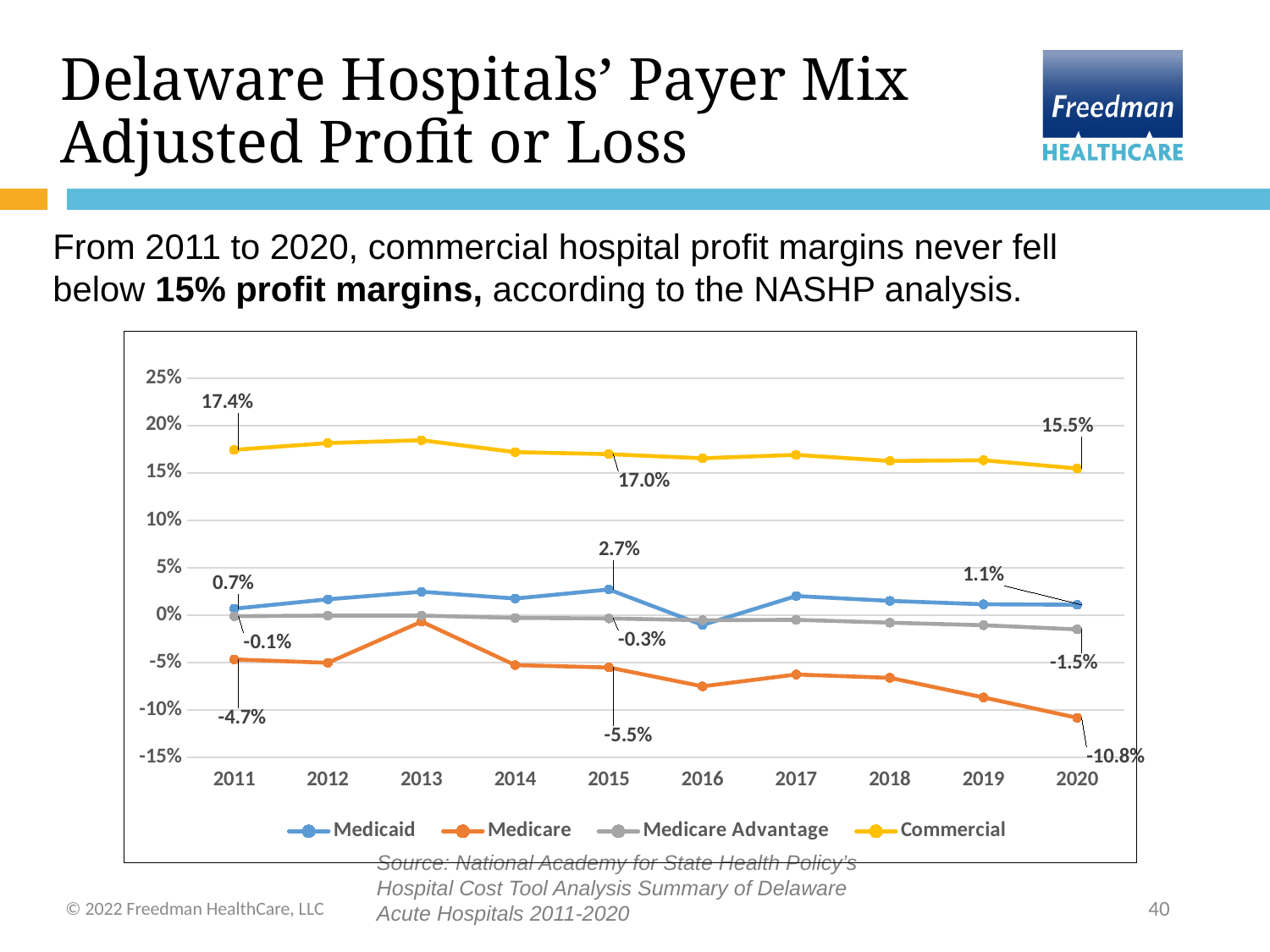
Which series had the lowest value in 2015? Medicare How many years are shown on the x axis? 10 Which is larger, the Medicaid value in 2011 or in 2015? 2015 What was the Commercial profit margin in 2011? 17.4% What was the Medicare profit margin in 2020? -10.8% How many series does the legend list? 4 What was the Medicaid value in 2015? 2.7% Which series had the highest value in 2020? Commercial What type of chart is shown on the slide? Line chart Does the Medicare line rise or fall from 2017 to 2020? Fall What is the difference between the Commercial value in 2011 and in 2020? 1.9% What was the Medicare Advantage value in 2020? -1.5%